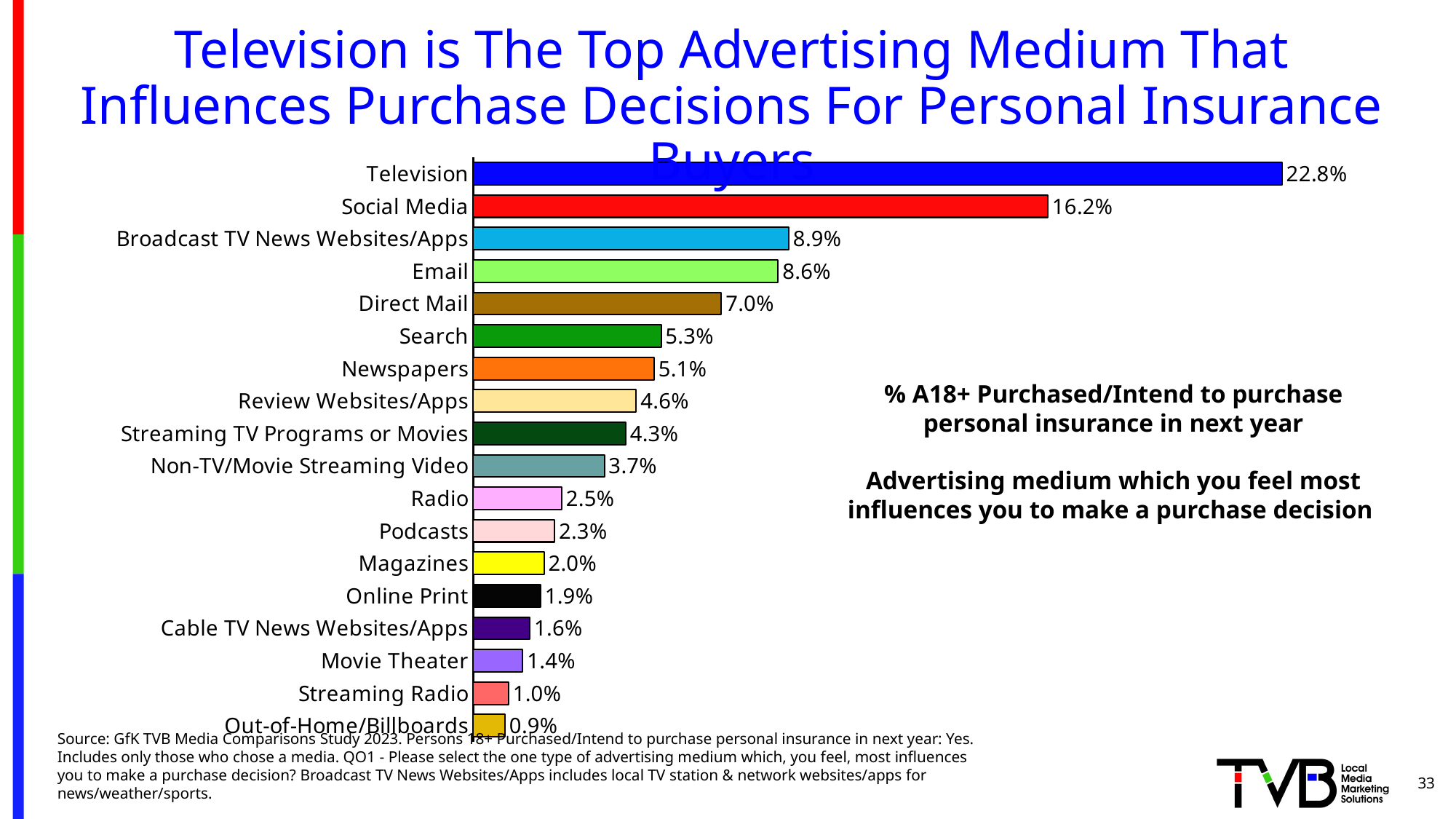
What is the value for Direct Mail? 7.0% Which advertising medium has the highest value? Television What is the value for Podcasts? 2.3% How many advertising media are shown in the chart? 18 What percentage is shown for Television? 22.8% Which advertising medium has the lowest value? Out-of-Home/Billboards Which has a larger value, Search or Newspapers? Search What is the difference between the values for Television and Social Media? 6.6% What is the difference between the values for Broadcast TV News Websites/Apps and Email? 0.3% What type of chart is shown on the slide? Bar chart What percentage is shown for Social Media? 16.2% What colour is the bar for Magazines? Yellow